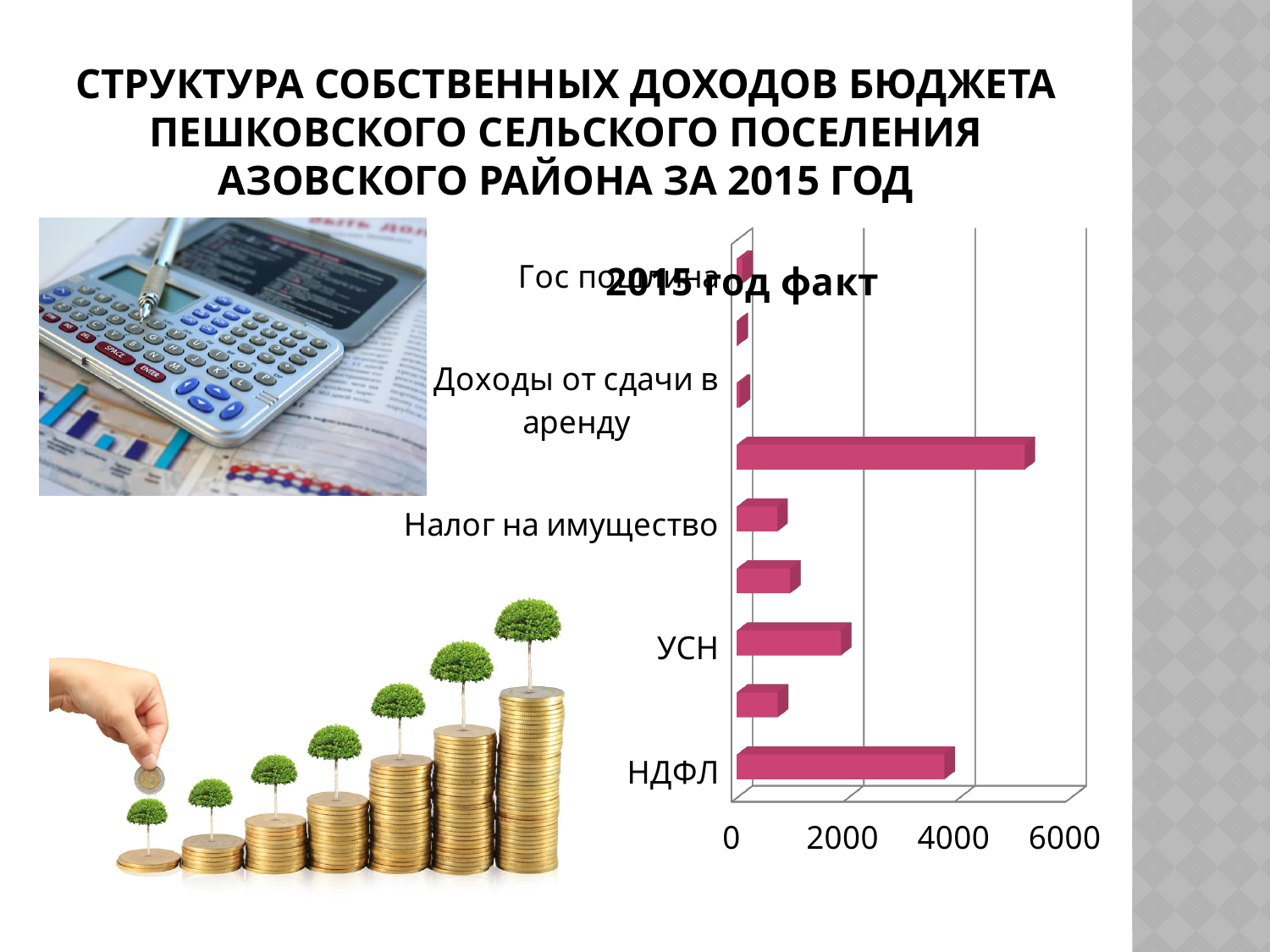
Which is larger, the value for УСН or the value for Налог на имущество? УСН Is the value for НДФЛ greater or less than 2000? greater How many bars are plotted in the chart? 9 Is the value for Налог на имущество greater or less than 2000? less Is the value for УСН greater or less than 4000? less What colour are the bars in the chart? pink What is the title of the chart? 2015 год факт Which is larger, the value for НДФЛ or the value for УСН? НДФЛ Among the labeled categories, which has the longest bar? НДФЛ What kind of chart is shown on the slide? bar chart